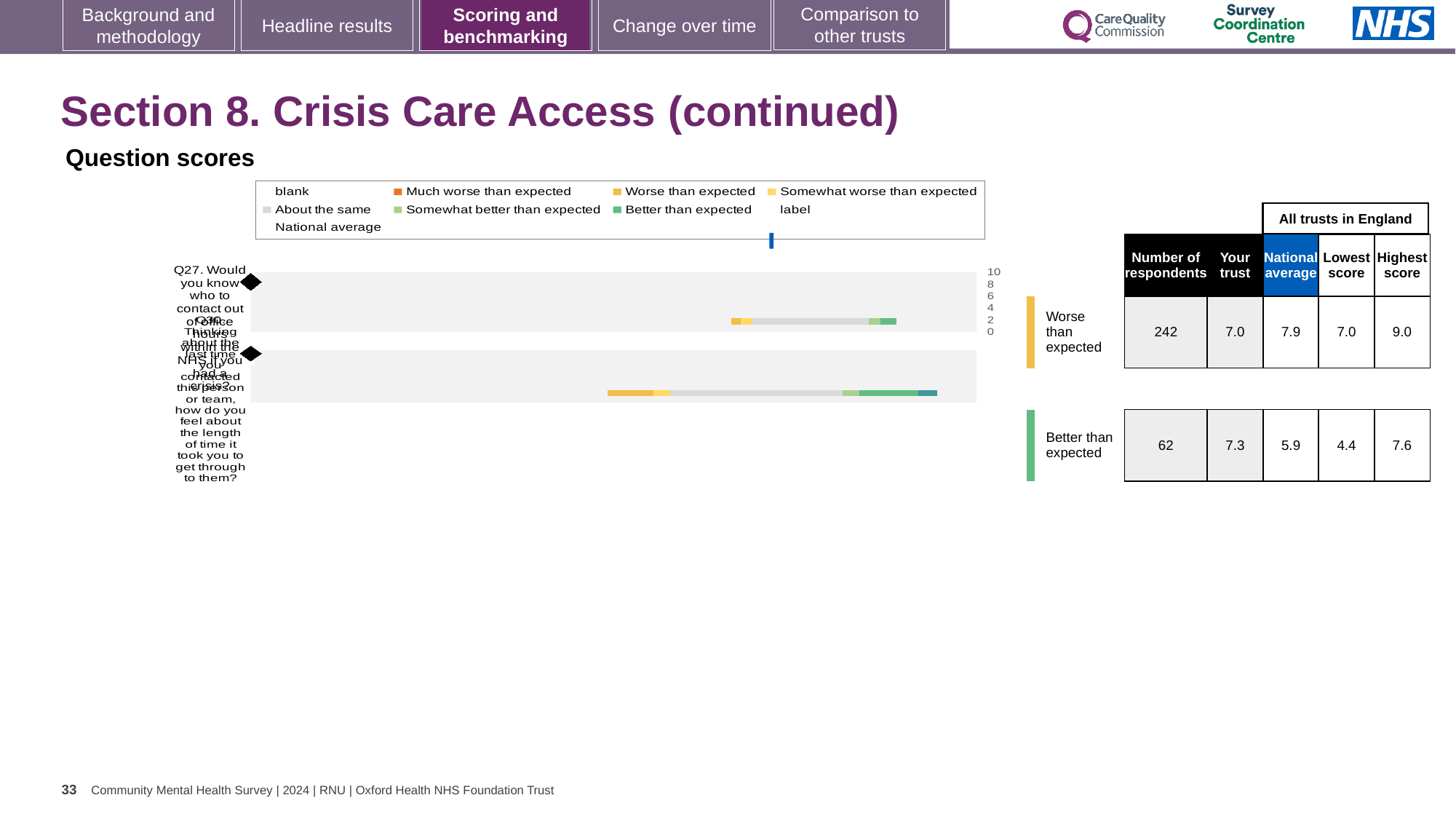
How many respondents answered Q27? 242 How many questions are plotted in the question scores chart? 2 What is the highest score among all trusts in England for Q30? 7.6 What is the difference between the highest and lowest scores for Q30? 3.2 What kind of chart is used to show the question scores? bar chart Which benchmark category is Q27 placed in? Worse than expected What is the highest value shown on the score axis of the chart? 10 Which question has the higher 'Your trust' score, Q27 or Q30? Q30 What is the 'Your trust' score for Q27? 7.0 What is the national average score for Q30? 5.9 What is the difference between the national average and the 'Your trust' score for Q27? 0.9 What is the lowest score among all trusts in England for Q27? 7.0